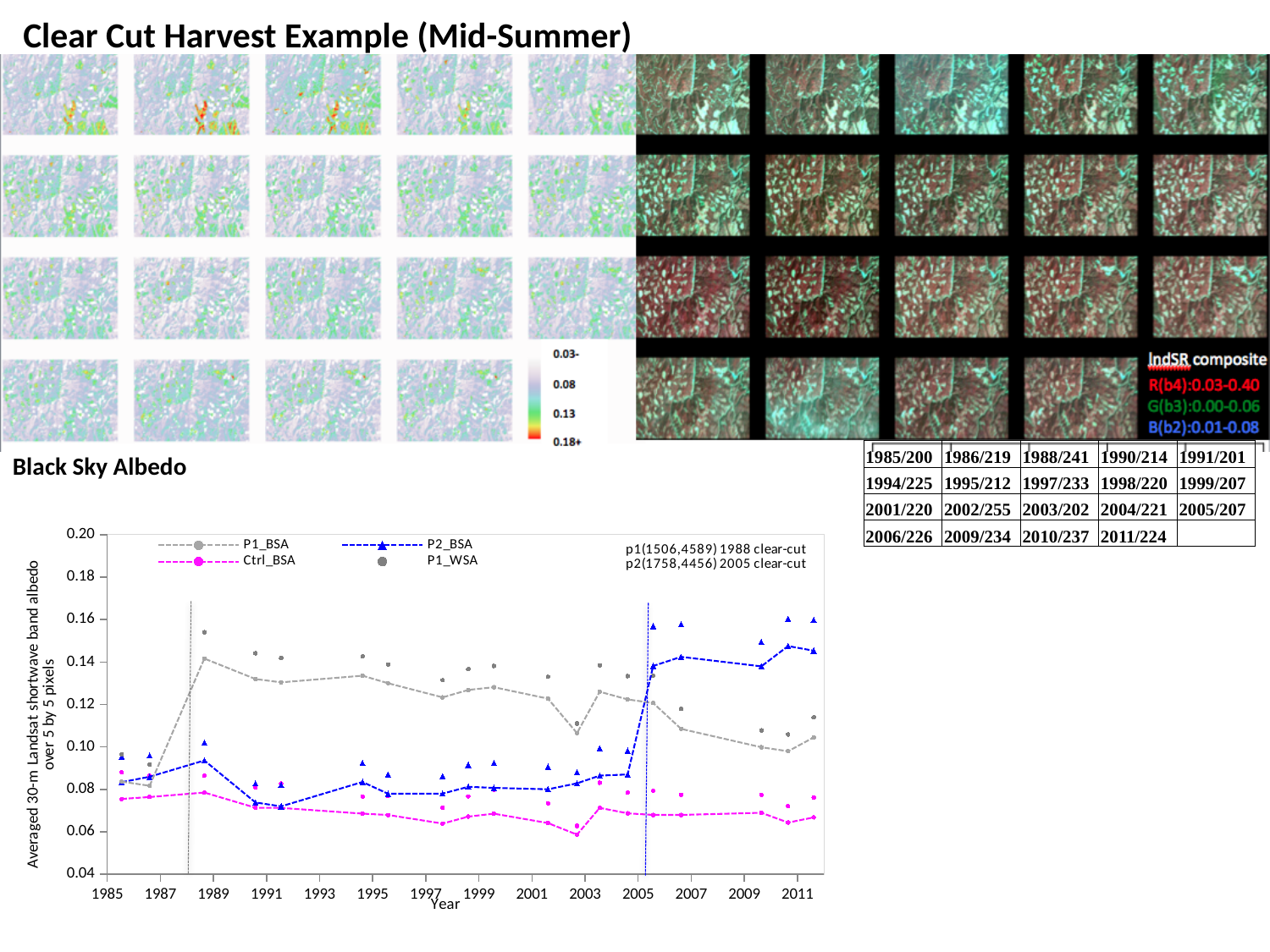
In the Black Sky Albedo chart, which series has the higher value in 1995, P1_BSA or Ctrl_BSA? P1_BSA In the Black Sky Albedo chart, is the Ctrl_BSA value in 2011 greater or less than 0.08? less In the Black Sky Albedo chart, which series stays lowest across the whole period? Ctrl_BSA In the Black Sky Albedo chart, does the P2_BSA series rise or fall between 2003 and 2007? rise In the Black Sky Albedo chart, does the P1_BSA series rise or fall between 2005 and 2011? fall In the Black Sky Albedo chart, is the P1_BSA value in 1989 greater or less than 0.12? greater According to the annotation on the Black Sky Albedo chart, in which year was p2 clear-cut? 2005 What kind of chart is the Black Sky Albedo chart? line chart In the Black Sky Albedo chart, is the P2_BSA value in 2007 greater or less than 0.12? greater How many series does the legend of the Black Sky Albedo chart list? 4 In the Black Sky Albedo chart, which series has the higher value in 2011, P1_BSA or P2_BSA? P2_BSA